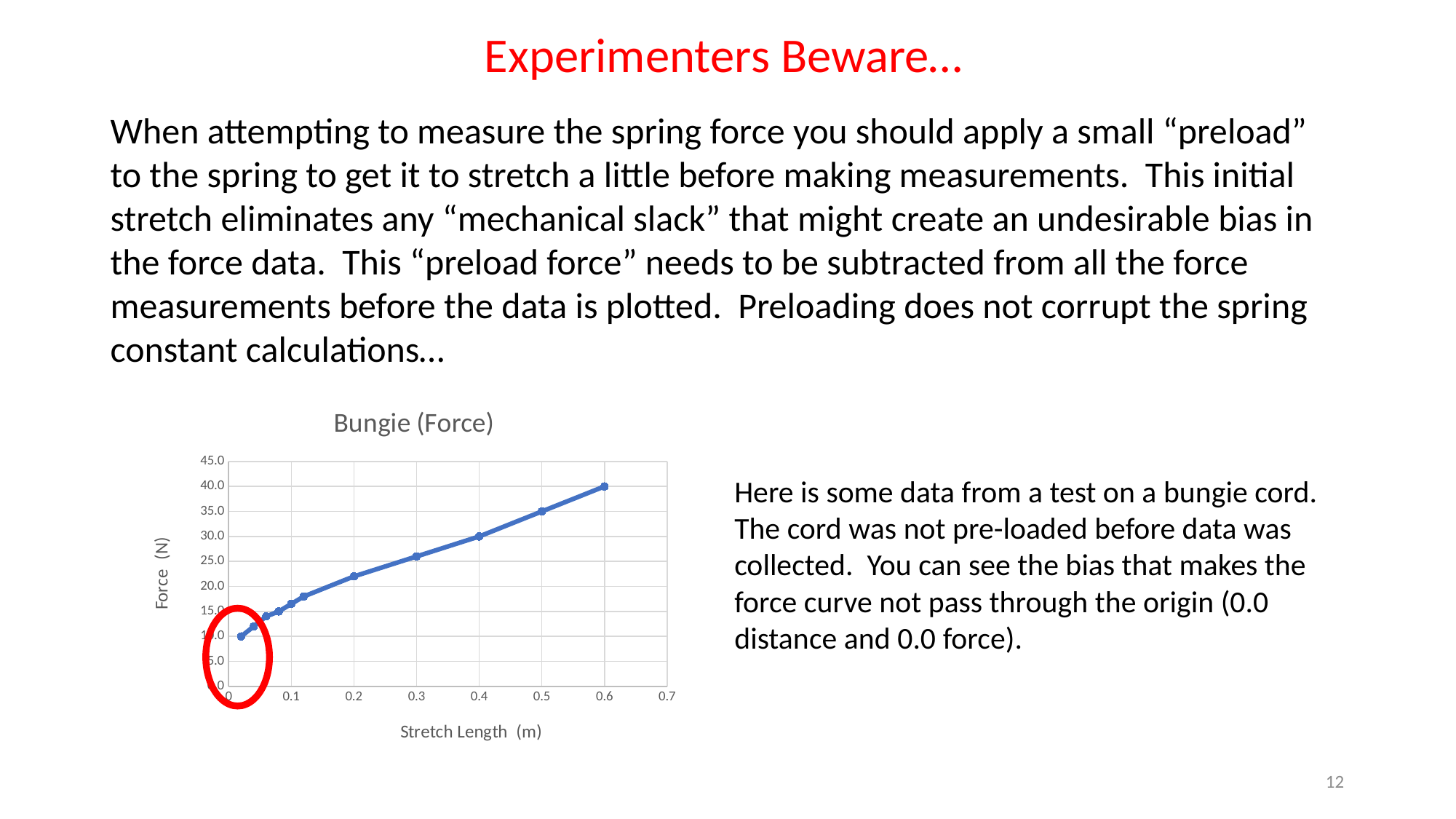
What is the force at a stretch length of 0.5 m? 35.0 What is the title of the chart? Bungie (Force) Is the force at a stretch length of 0.2 m greater or less than 20.0? greater At which stretch length is the force highest? 0.6 What is the label of the x axis of the chart? Stretch Length (m) What is the force at a stretch length of 0.4 m? 30.0 Is the force at a stretch length of 0.3 m greater or less than 30.0? less Does the force rise or fall as stretch length increases along the x axis? rise What kind of chart is shown on the slide? line chart What is the difference in force between stretch lengths of 0.6 m and 0.4 m? 10.0 What is the force at a stretch length of 0.6 m? 40.0